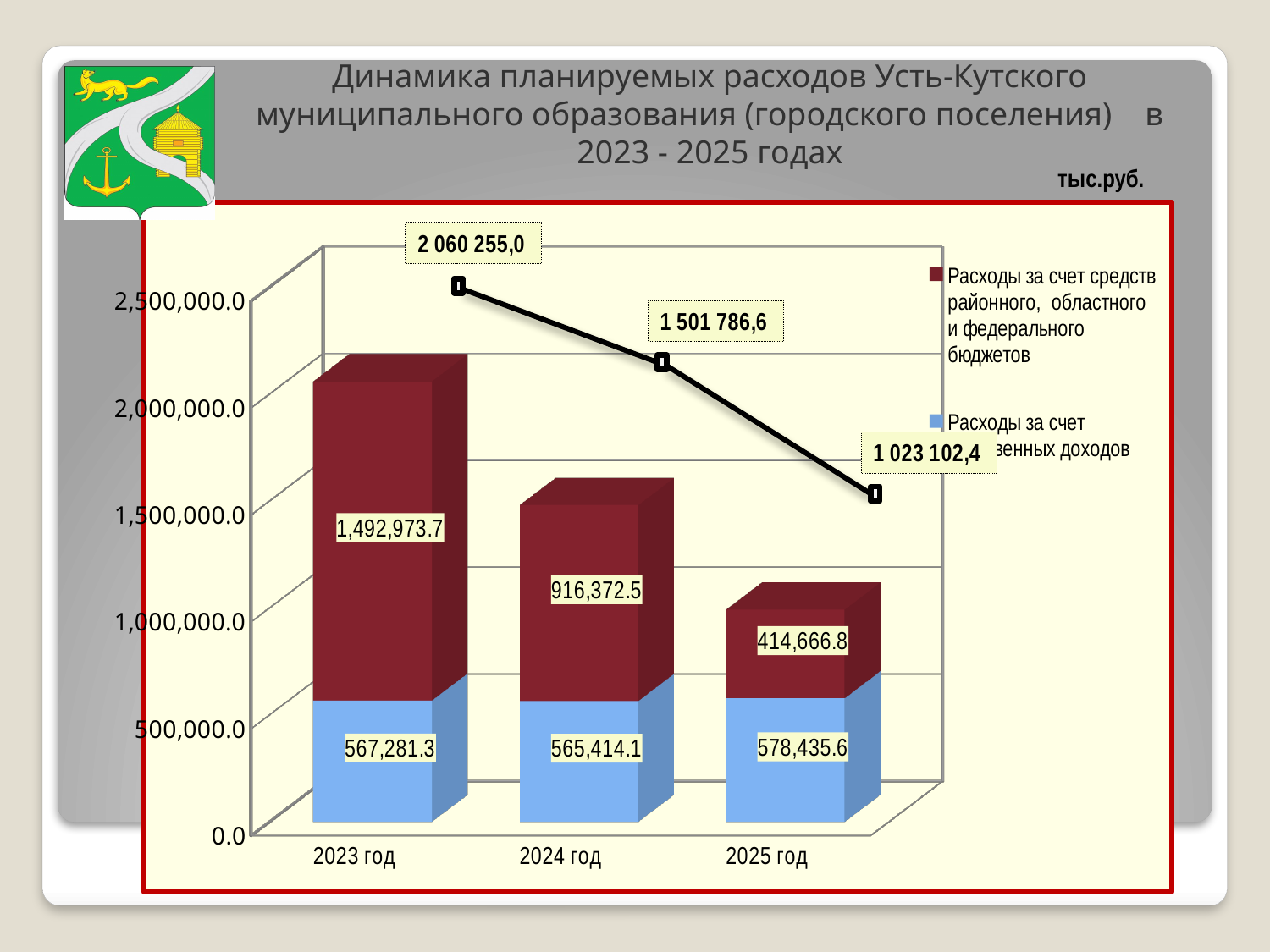
How many series does the legend list? 2 Which year has the highest value for the dark red segment (расходы за счет средств районного, областного и федерального бюджетов)? 2023 год Do the values of the dark red segment rise or fall from 2023 год to 2025 год? Fall What value does the line label show for 2025 год? 1 023 102,4 What value does the line label show for 2023 год? 2 060 255,0 What is the difference between the dark red segment values for 2023 год and 2024 год? 576,601.2 Which is larger: the blue segment for 2025 год or the blue segment for 2023 год? 2025 год How many years are shown on the x axis? 3 What is the value of the 'Расходы за счет средств районного, областного и федерального бюджетов' segment for 2023 год? 1,492,973.7 What kind of chart is shown on the slide? Stacked bar chart with a line What is the value of the blue (lower) segment for 2024 год? 565,414.1 Which year has the lowest value for the dark red segment? 2025 год